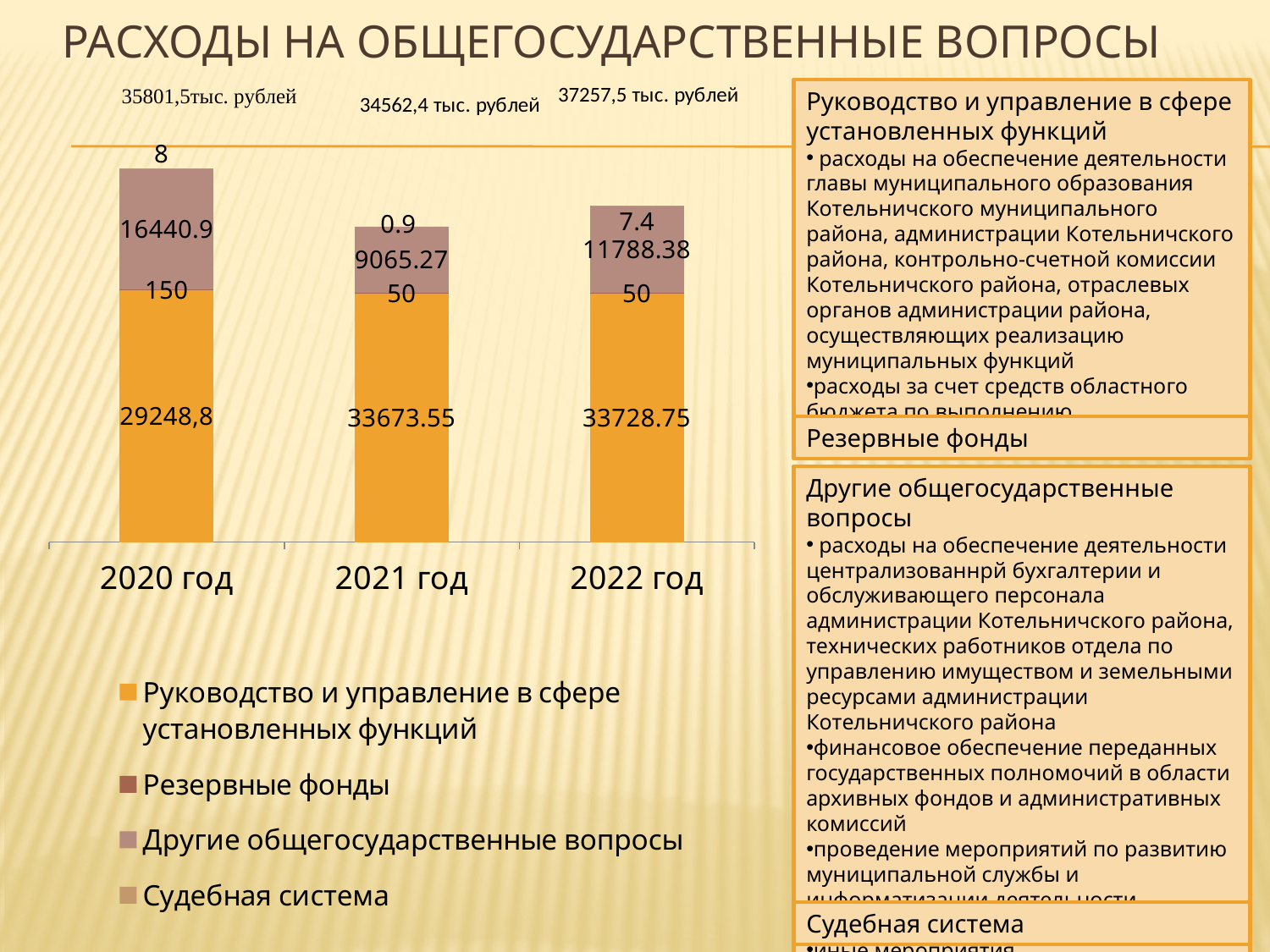
What is the value for 'Другие общегосударственные вопросы' in 2021 год? 9065.27 How many series does the chart legend list? 4 How many years (categories) are shown on the x axis of the chart? 3 What is the value for 'Руководство и управление в сфере установленных функций' in 2020 год? 29248,8 What is the value for 'Резервные фонды' in 2020 год? 150 What is the value for 'Руководство и управление в сфере установленных функций' in 2022 год? 33728.75 In which year is the value for 'Другие общегосударственные вопросы' the highest? 2020 год What is the difference between the 'Резервные фонды' values in 2020 год and 2021 год? 100 What is the value for 'Судебная система' in 2022 год? 7.4 What kind of chart is shown on the slide? stacked bar chart In which year is the value for 'Другие общегосударственные вопросы' the lowest? 2021 год